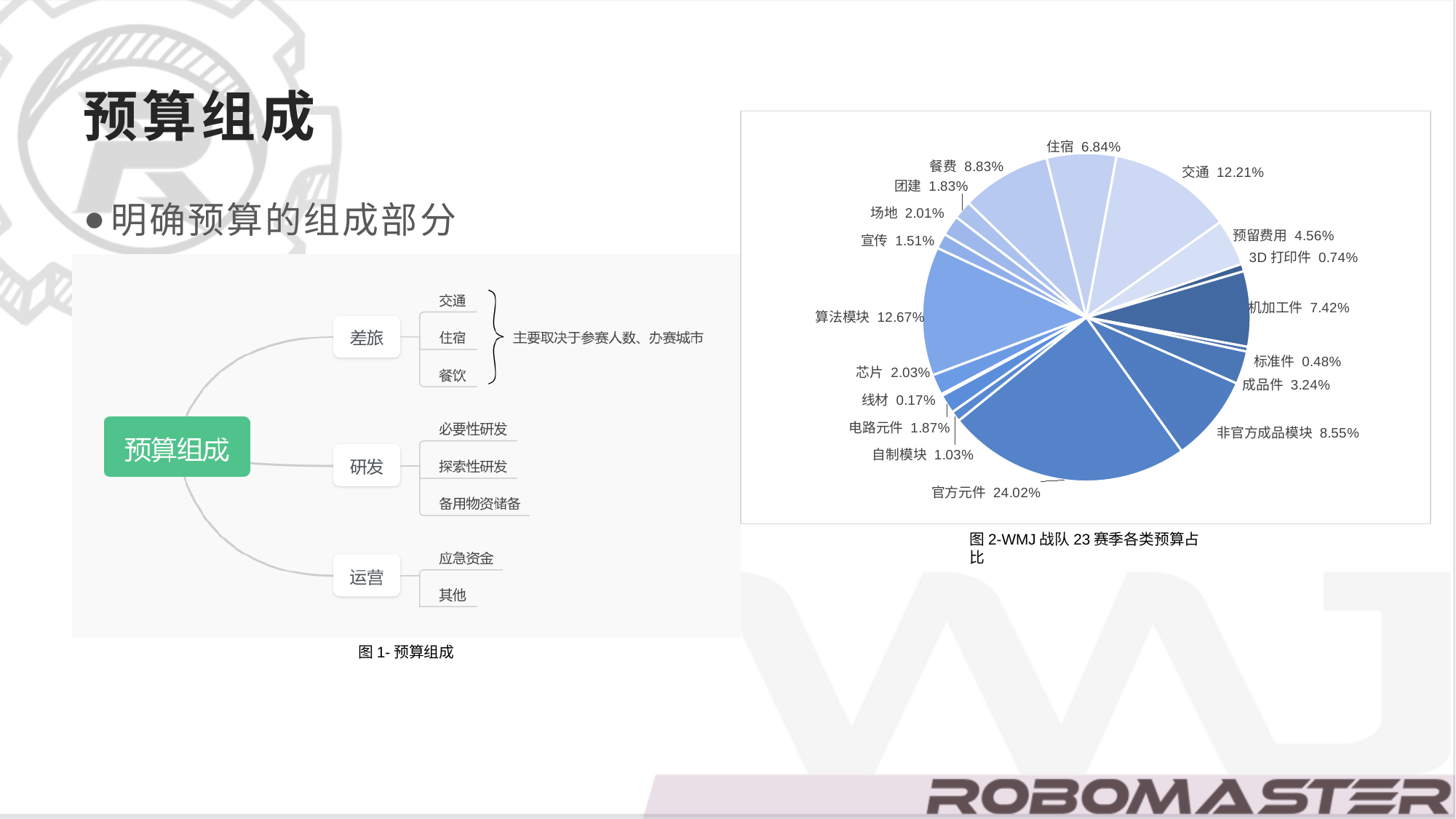
What percentage is shown for 3D 打印件 in the pie chart? 0.74% What kind of chart is shown on the slide? pie chart What is the difference between the shares of 算法模块 and 交通 in the pie chart? 0.46% What percentage is shown for 算法模块 in the pie chart? 12.67% What percentage is shown for 交通 in the pie chart? 12.21% Which category has the smallest share in the pie chart? 线材 How many categories are shown in the pie chart? 18 What is the caption of the pie chart on the slide? 图 2-WMJ 战队 23 赛季各类预算占比 What share of the budget does 官方元件 account for in the pie chart? 24.02% Which category has the largest share in the pie chart? 官方元件 Which has a larger share in the pie chart, 机加工件 or 非官方成品模块? 非官方成品模块 What is the difference between the shares of 餐费 and 住宿 in the pie chart? 1.99%